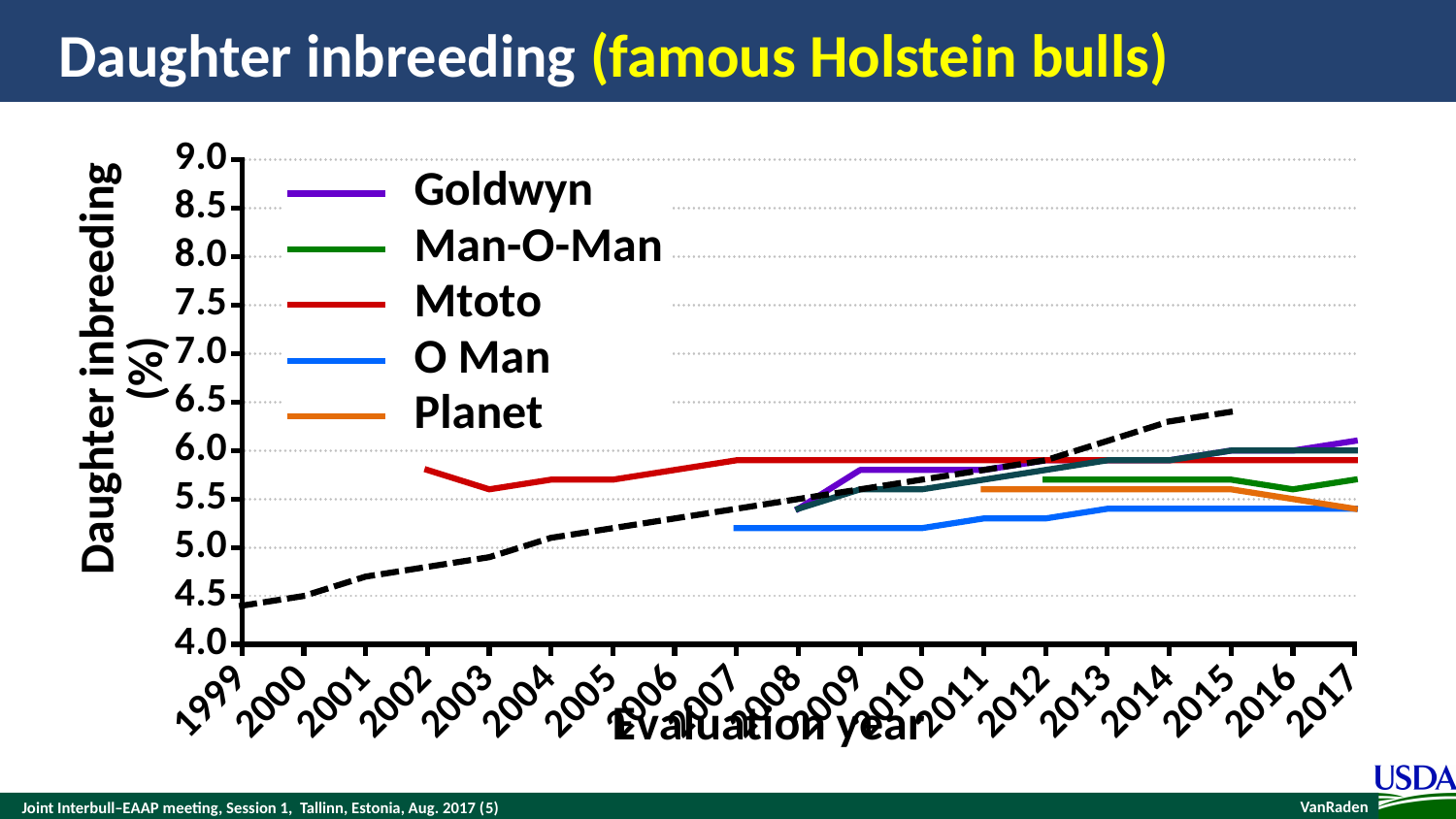
What is the label of the y axis? Daughter inbreeding (%) What kind of chart is shown on the slide? line chart Is the value for O Man in 2007 greater or less than 5.5? less Does the black dashed line rise or fall from 1999 to 2015? rise Is the value of the black dashed line in 2015 greater or less than 6.0? greater Is the value for Mtoto in 2002 greater or less than 6.0? less In 2017, which is larger, the value for Goldwyn or the value for O Man? Goldwyn How many series does the legend list? 5 How many evaluation years are labelled on the x axis? 19 Which legend series has the lowest value in 2010? O Man In 2010, which is larger, the value for Mtoto or the value for O Man? Mtoto